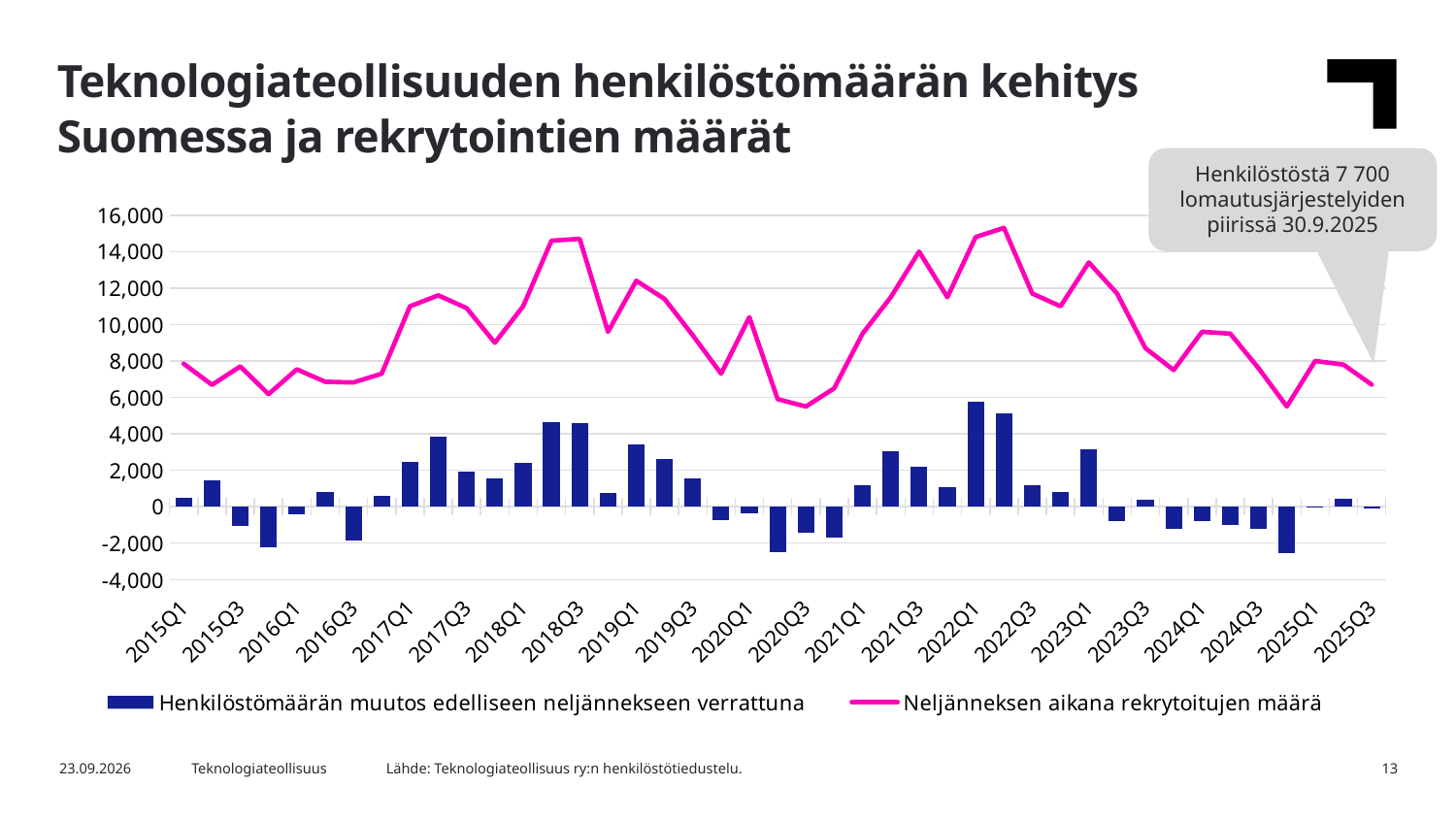
Which is larger for the 'Neljänneksen aikana rekrytoitujen määrä' line: the value at 2022Q1 or the value at 2015Q1? 2022Q1 What is the title of the chart on the slide? Teknologiateollisuuden henkilöstömäärän kehitys Suomessa ja rekrytointien määrät Does the 'Neljänneksen aikana rekrytoitujen määrä' line generally rise or fall from 2022Q1 to 2025Q3? fall Which quarter has the tallest bar for 'Henkilöstömäärän muutos edelliseen neljännekseen verrattuna'? 2022Q1 Which series is drawn as a line: 'Henkilöstömäärän muutos edelliseen neljännekseen verrattuna' or 'Neljänneksen aikana rekrytoitujen määrä'? Neljänneksen aikana rekrytoitujen määrä How many series does the legend list? 2 Is the value of the 'Neljänneksen aikana rekrytoitujen määrä' line at 2015Q1 greater or less than 6,000? greater Is the value of the 'Neljänneksen aikana rekrytoitujen määrä' line at 2025Q3 greater or less than 8,000? less Is the bar for 'Henkilöstömäärän muutos edelliseen neljännekseen verrattuna' at 2016Q1 greater or less than 0? less What kind of chart is shown on the slide? A combined bar and line chart